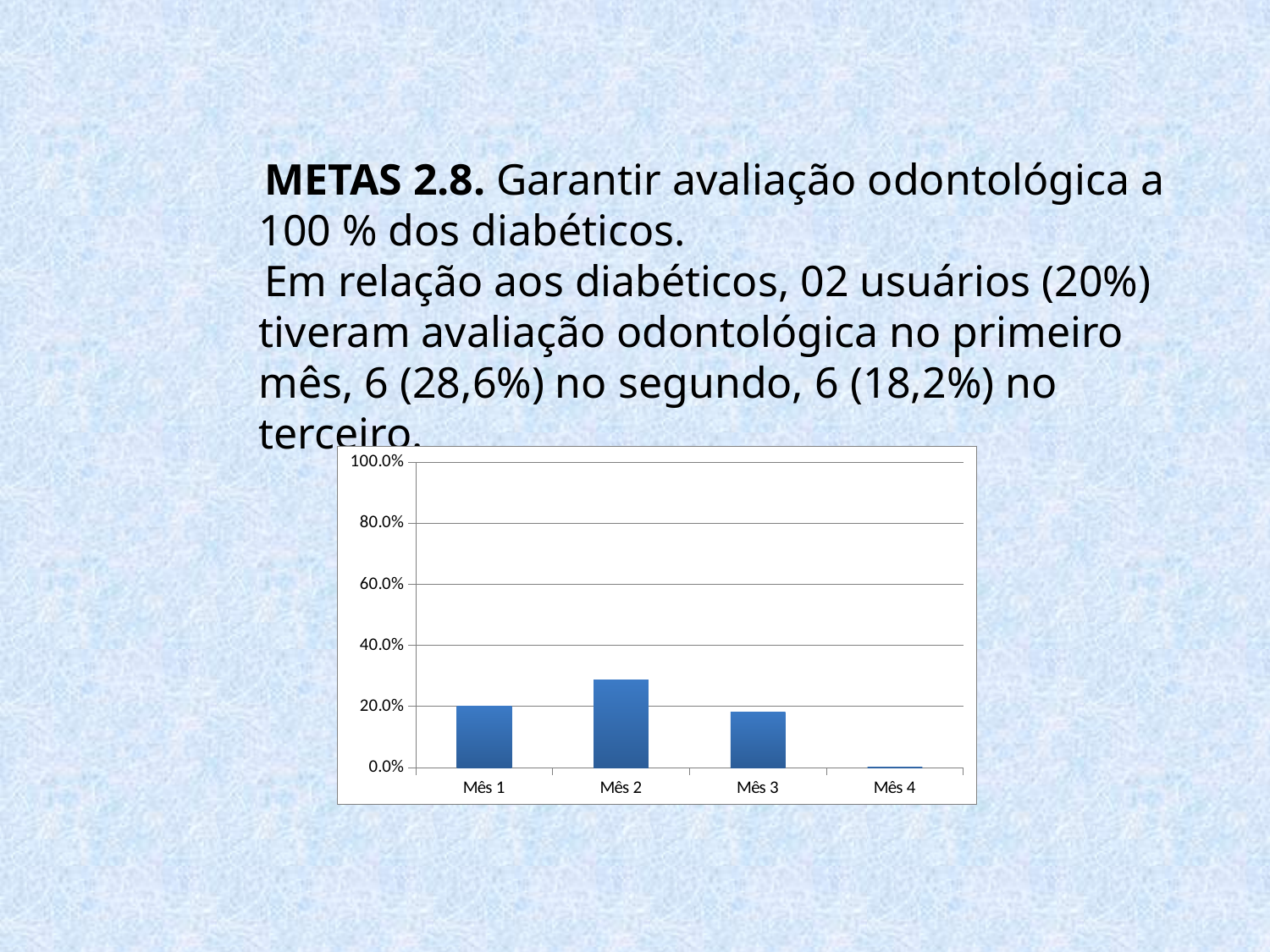
Which is larger, the value for Mês 1 or the value for Mês 4? Mês 1 How many categories are shown on the x axis of the chart? 4 Do the values rise or fall from Mês 2 to Mês 4? fall Is the value for Mês 2 greater or less than 20.0%? greater Is the value for Mês 2 greater or less than 40.0%? less Which is larger, the value for Mês 2 or the value for Mês 3? Mês 2 What is the highest value shown on the y axis of the chart? 100.0% What colour are the bars in the chart? blue Which month has the highest bar in the chart? Mês 2 Which month has the lowest bar in the chart? Mês 4 What kind of chart is shown on the slide? bar chart Is the value for Mês 3 greater or less than 20.0%? less